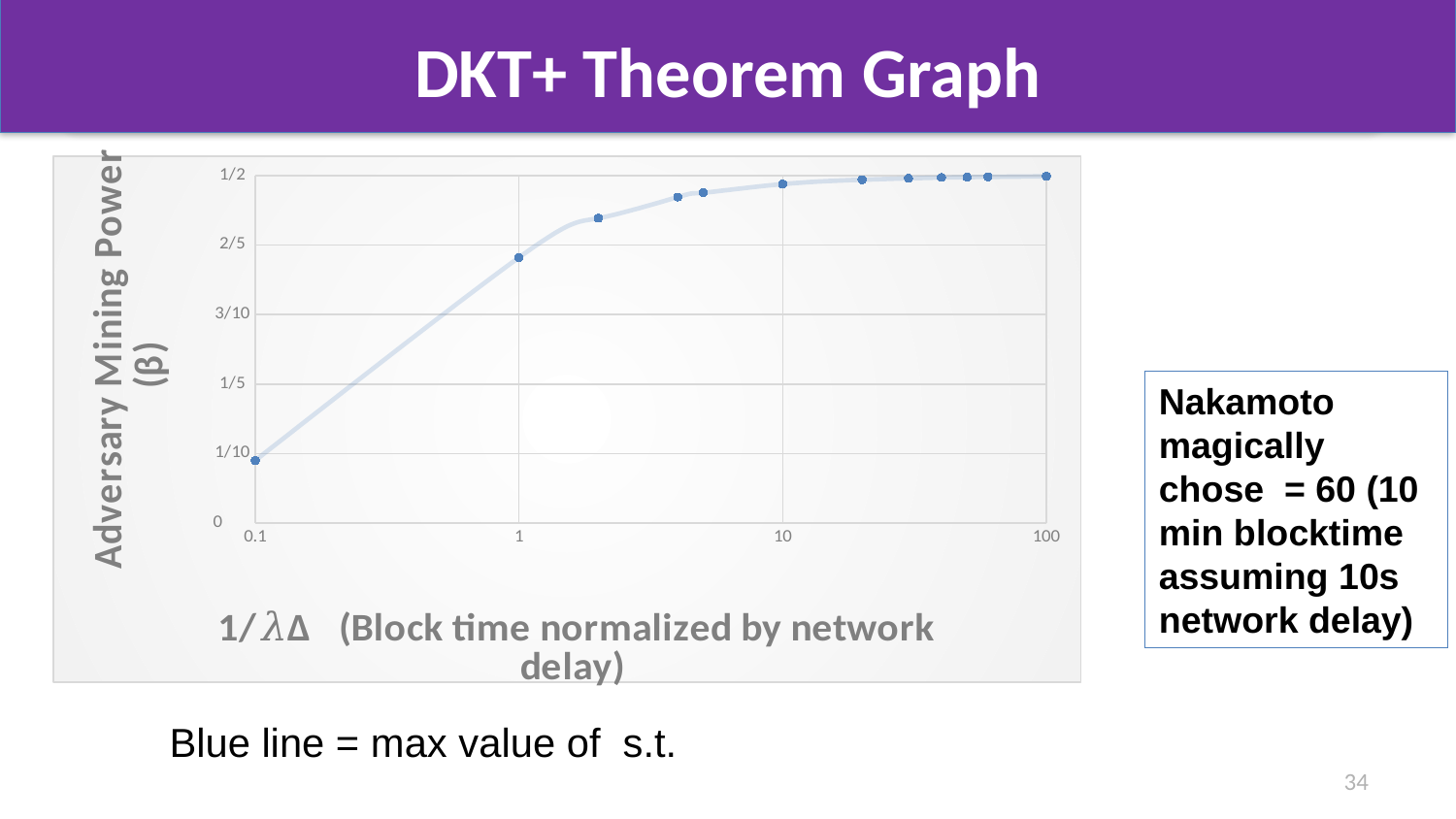
What is the label of the vertical axis? Adversary Mining Power (β) Do the plotted values rise or fall as the x-axis value increases from 0.1 to 100? rise Is the value plotted at x = 1 greater or less than 2/5? less Is the value plotted at x = 0.1 greater or less than 1/5? less At which x-axis value is the plotted adversary mining power lowest? 0.1 Which plotted value is larger, the one at x = 1 or the one at x = 10? x = 10 Is the value plotted at x = 1 greater or less than 3/10? greater How many data points are plotted on the chart? 12 What is the title of the chart? DKT+ Theorem Graph What kind of chart is shown on the slide? line chart